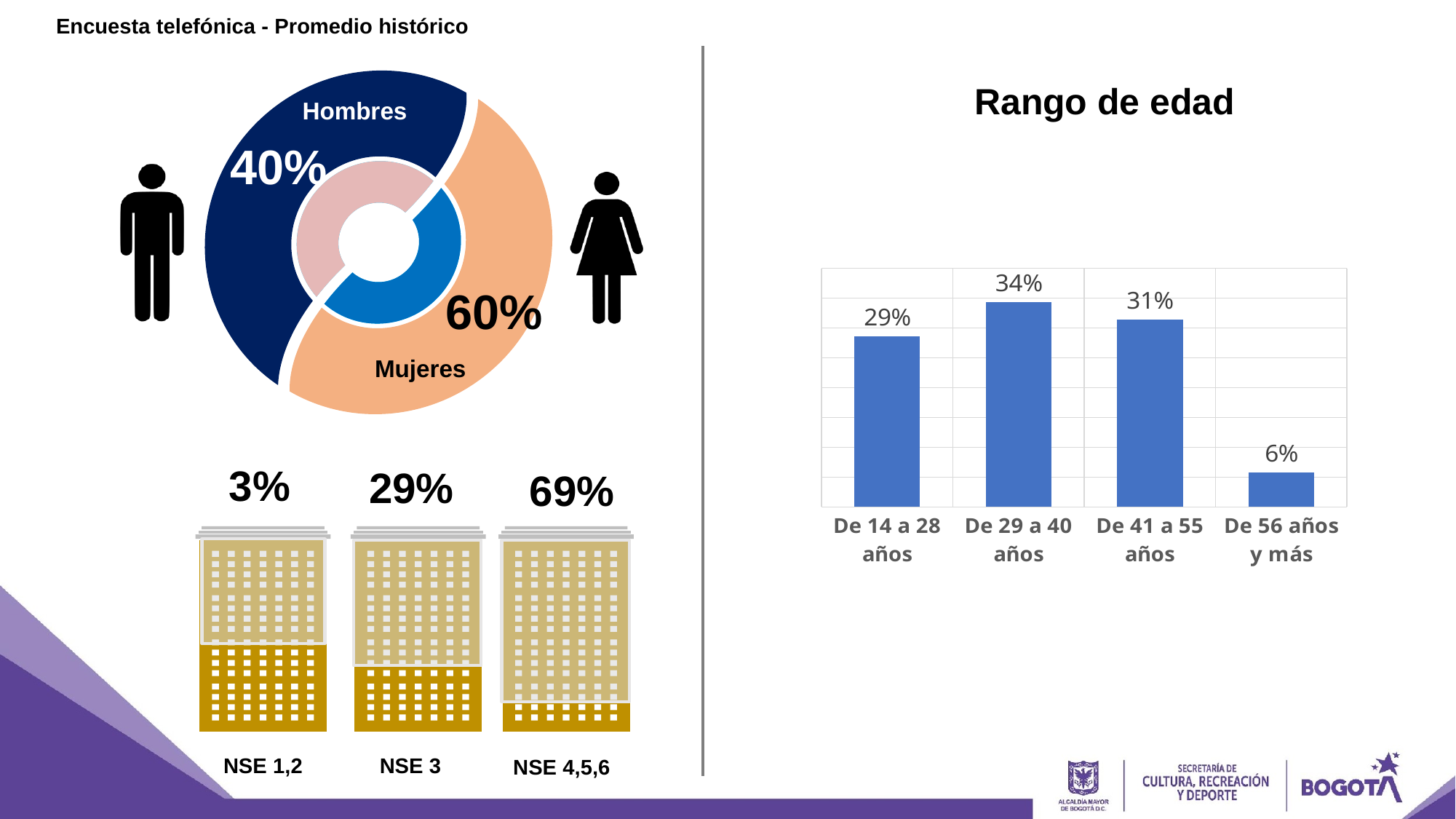
In the 'Rango de edad' bar chart, how many age ranges are shown? 4 In the gender donut chart on the left, which group is larger, Hombres or Mujeres? Mujeres In the 'Rango de edad' bar chart, which age range has the highest value? De 29 a 40 años In the gender donut chart on the left, what share is 'Hombres'? 40% In the gender donut chart on the left, what share is 'Mujeres'? 60% In the 'Rango de edad' bar chart, what is the value for 'De 56 años y más'? 6% What kind of chart is the 'Rango de edad' chart? bar chart In the 'Rango de edad' bar chart, what is the value for 'De 29 a 40 años'? 34% In the 'Rango de edad' bar chart, which age range has the lowest value? De 56 años y más In the NSE building infographic at the bottom left, what is the difference between 'NSE 3' and 'NSE 1,2'? 26% In the NSE building infographic at the bottom left, what is the value for 'NSE 4,5,6'? 69% In the 'Rango de edad' bar chart, what is the difference between 'De 41 a 55 años' and 'De 14 a 28 años'? 2%